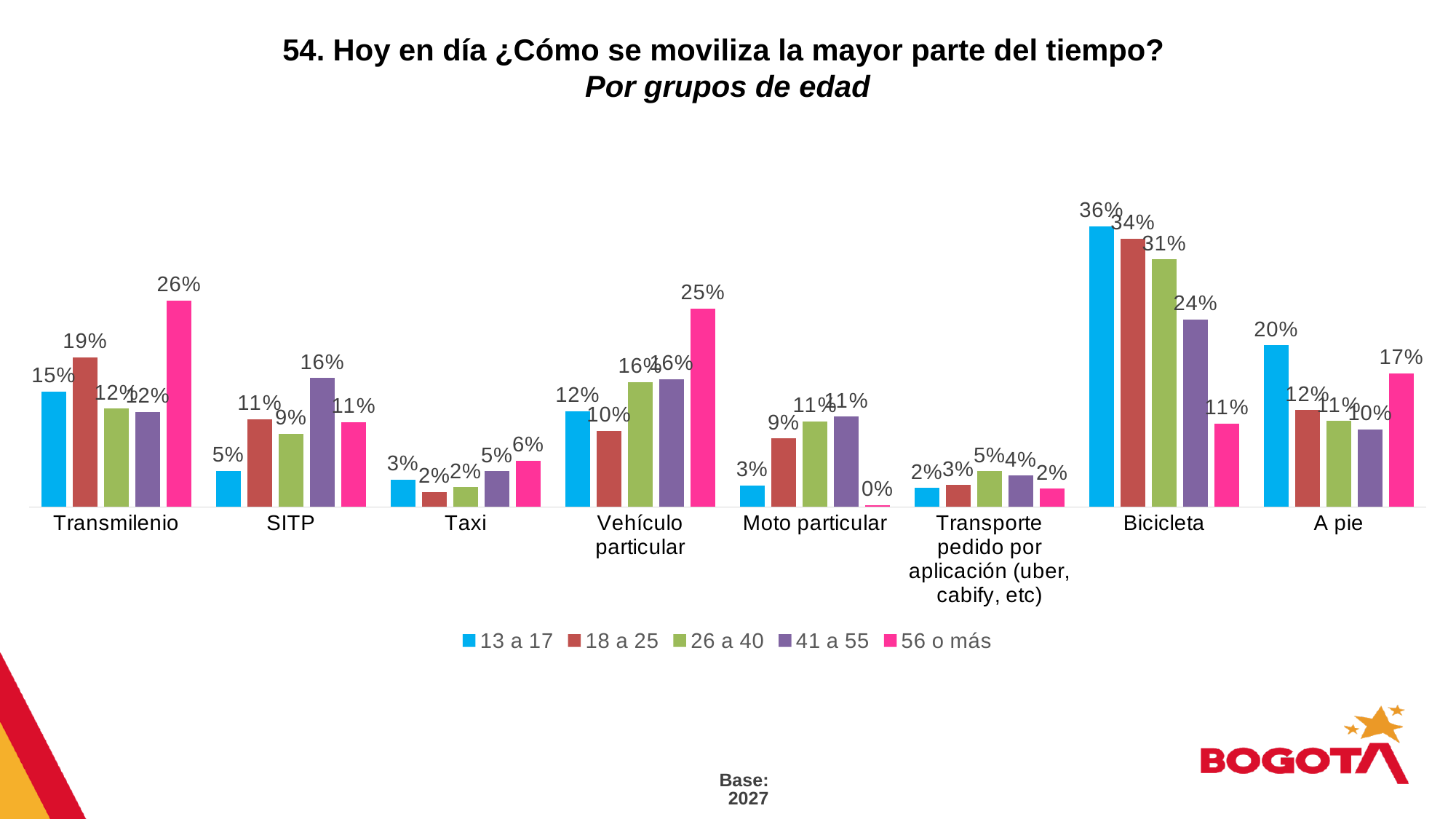
What is the value for the 13 a 17 group for Bicicleta? 36% For Vehículo particular, which is larger: the value for 13 a 17 or for 56 o más? 56 o más What is the value for the 41 a 55 group for SITP? 16% Which category has the highest value for the 18 a 25 series? Bicicleta How many series does the legend list? 5 What is the difference between the 13 a 17 and 56 o más values for Bicicleta? 25% What kind of chart is shown on the slide? Bar chart What is the value for the 56 o más group for Moto particular? 0% What is the base (number of respondents) shown on the slide? 2027 Which age group has the lowest value for Bicicleta? 56 o más How many transport categories are shown on the x axis? 8 What percentage of the 56 o más group uses Transmilenio? 26%